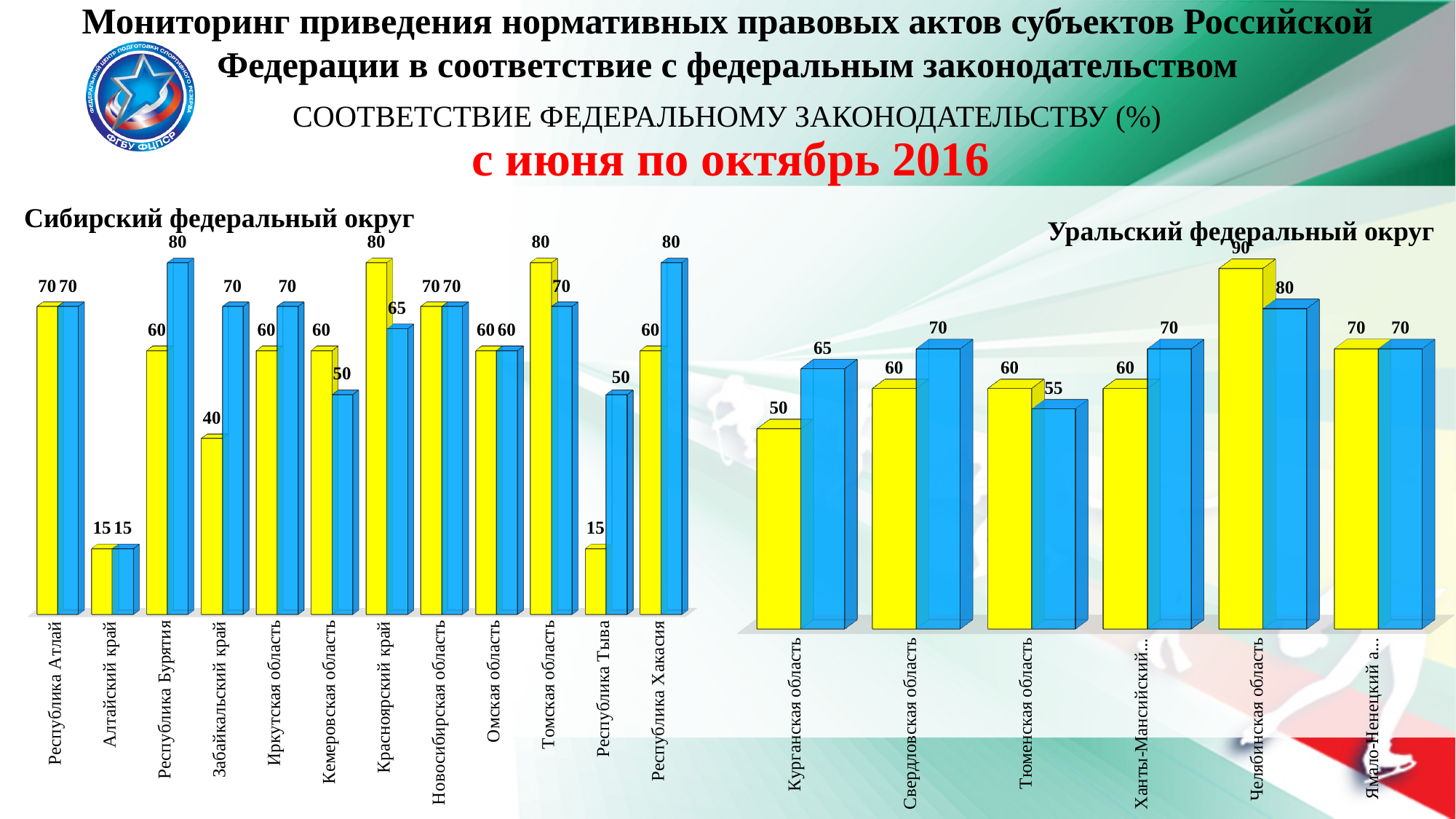
What type of chart is used for the Сибирский федеральный округ data? bar chart In the Уральский федеральный округ chart, what is the difference between the blue and yellow bars for Курганская область? 15 In the Уральский федеральный округ chart, which category has the highest yellow bar? Челябинская область How many categories are shown in the Уральский федеральный округ chart? 6 How many categories are shown in the Сибирский федеральный округ chart? 12 In the Сибирский федеральный округ chart, what is the difference between the blue and yellow bars for Республика Бурятия? 20 In the Сибирский федеральный округ chart, which category has the lowest blue bar? Алтайский край In the Сибирский федеральный округ chart, which is larger for Кемеровская область: the yellow bar or the blue bar? the yellow bar In the Уральский федеральный округ chart, what is the value of the blue bar for Тюменская область? 55 In the Сибирский федеральный округ chart, what is the value of the blue bar for Республика Тыва? 50 In the Сибирский федеральный округ chart, what is the value of the yellow bar for Забайкальский край? 40 In the Уральский федеральный округ chart, what is the value of the yellow bar for Челябинская область? 90